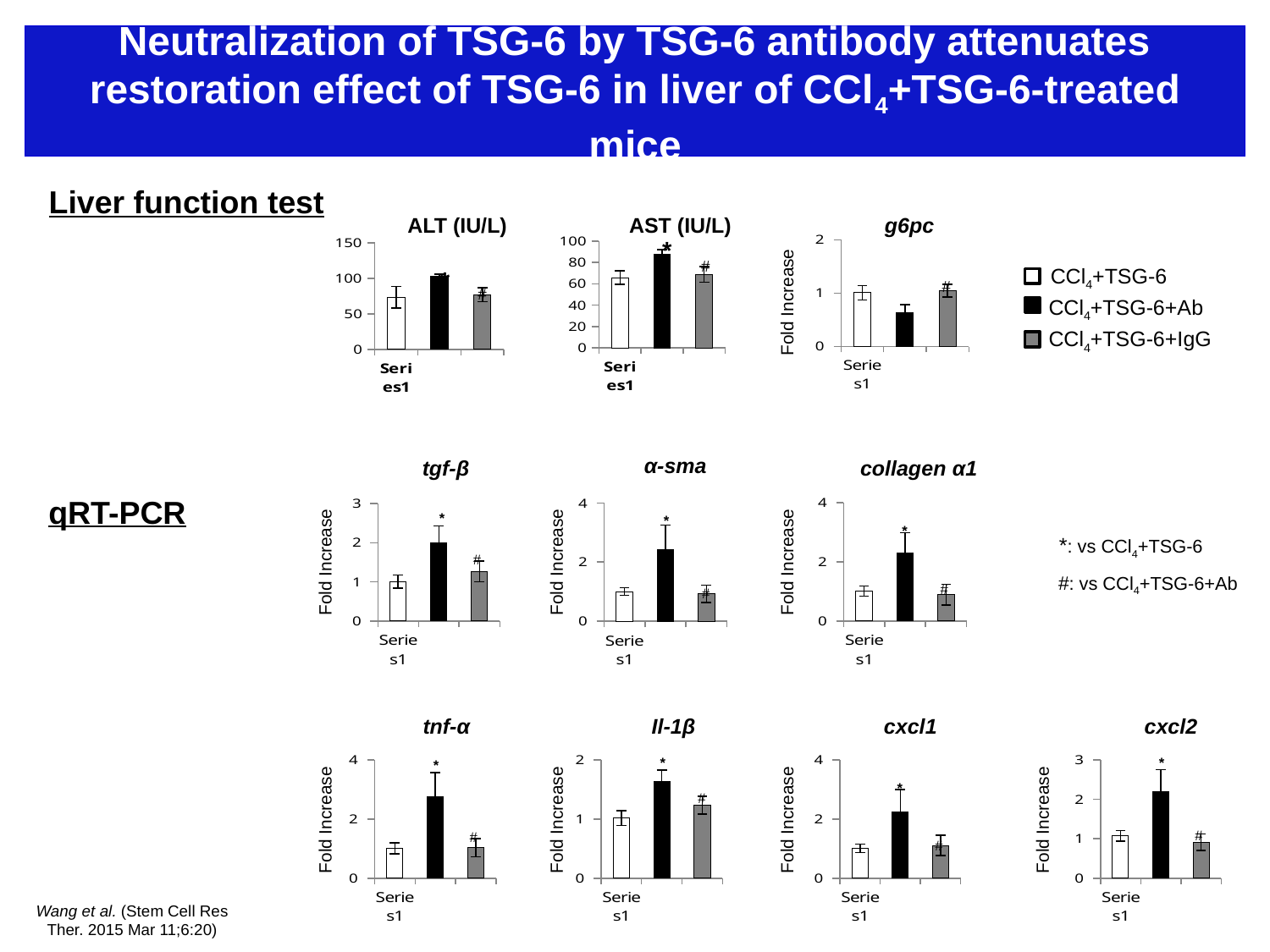
How many series does the legend on the slide list? 3 What is the y-axis label of the collagen α1 chart? Fold Increase In the cxcl2 chart, which is larger: the value for CCl4+TSG-6+Ab or the value for CCl4+TSG-6+IgG? CCl4+TSG-6+Ab In the g6pc chart, which group has the lowest value? CCl4+TSG-6+Ab In the tnf-α chart, is the value for CCl4+TSG-6 greater or less than 2? less In the α-sma chart, is the value for CCl4+TSG-6+Ab greater or less than 2? greater How many bars are plotted in the tgf-β chart? 3 In the ALT (IU/L) chart, which group has the highest value? CCl4+TSG-6+Ab In the g6pc chart, which is larger: the value for CCl4+TSG-6 or the value for CCl4+TSG-6+Ab? CCl4+TSG-6 In the ALT (IU/L) chart, is the value for CCl4+TSG-6 greater or less than 100? less What kind of chart is the ALT (IU/L) chart? bar chart